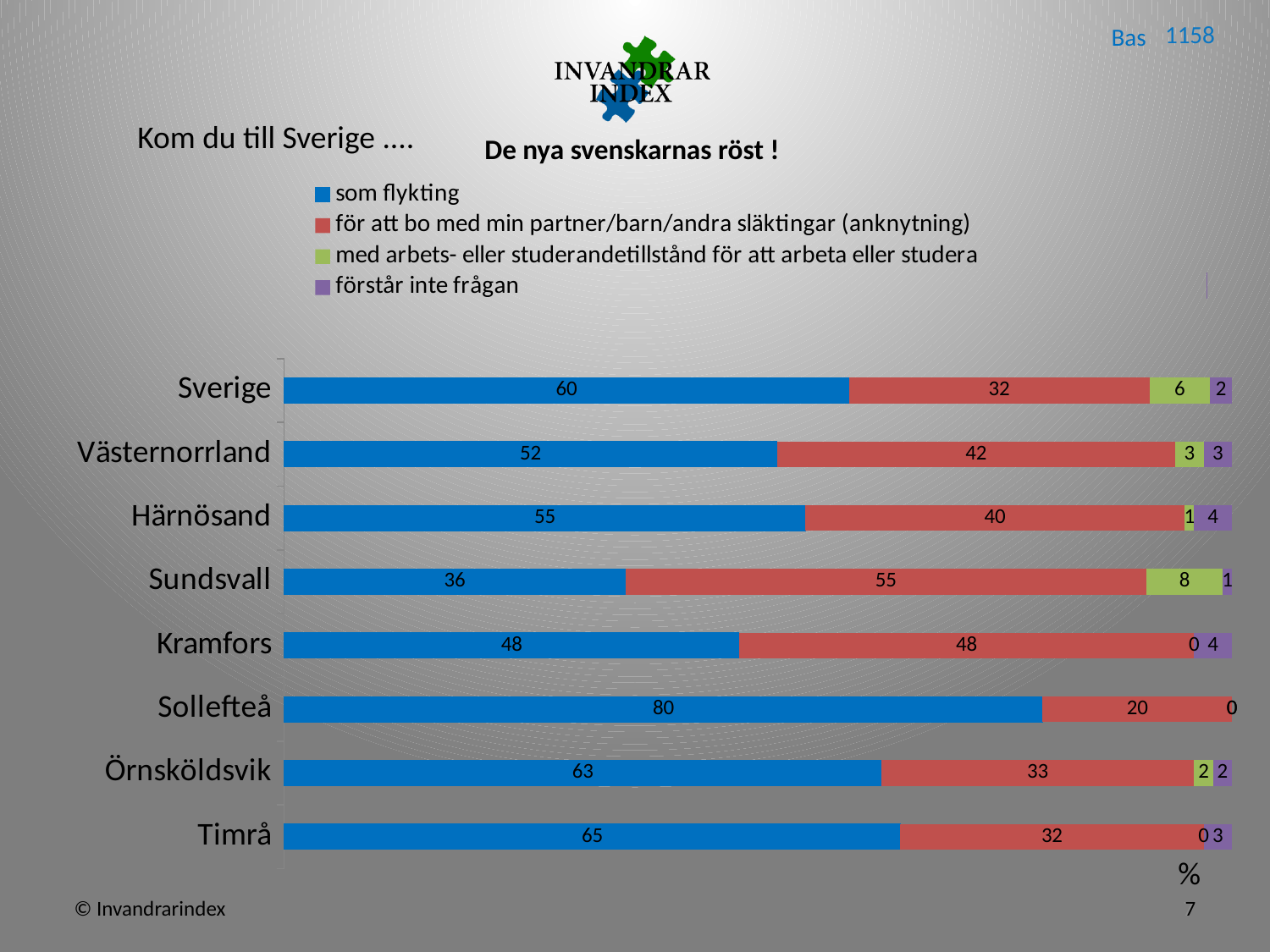
Which category has the lowest value for 'som flykting'? Sundsvall How many series does the legend list? 4 What is the value for 'som flykting' for Sollefteå? 80 What is the value for 'för att bo med min partner/barn/andra släktingar (anknytning)' for Västernorrland? 42 Which category has the highest value for 'som flykting'? Sollefteå What is the value for 'med arbets- eller studerandetillstånd för att arbeta eller studera' for Sundsvall? 8 Which is larger for Sundsvall: 'som flykting' or 'för att bo med min partner/barn/andra släktingar (anknytning)'? för att bo med min partner/barn/andra släktingar (anknytning) What kind of chart is shown on the slide? stacked bar chart What is the difference between the 'som flykting' values for Timrå and Sverige? 5 Which colour represents 'förstår inte frågan' in the legend? purple What is the total of the stacked bar for Sverige? 100 How many categories (regions) are plotted on the chart? 8